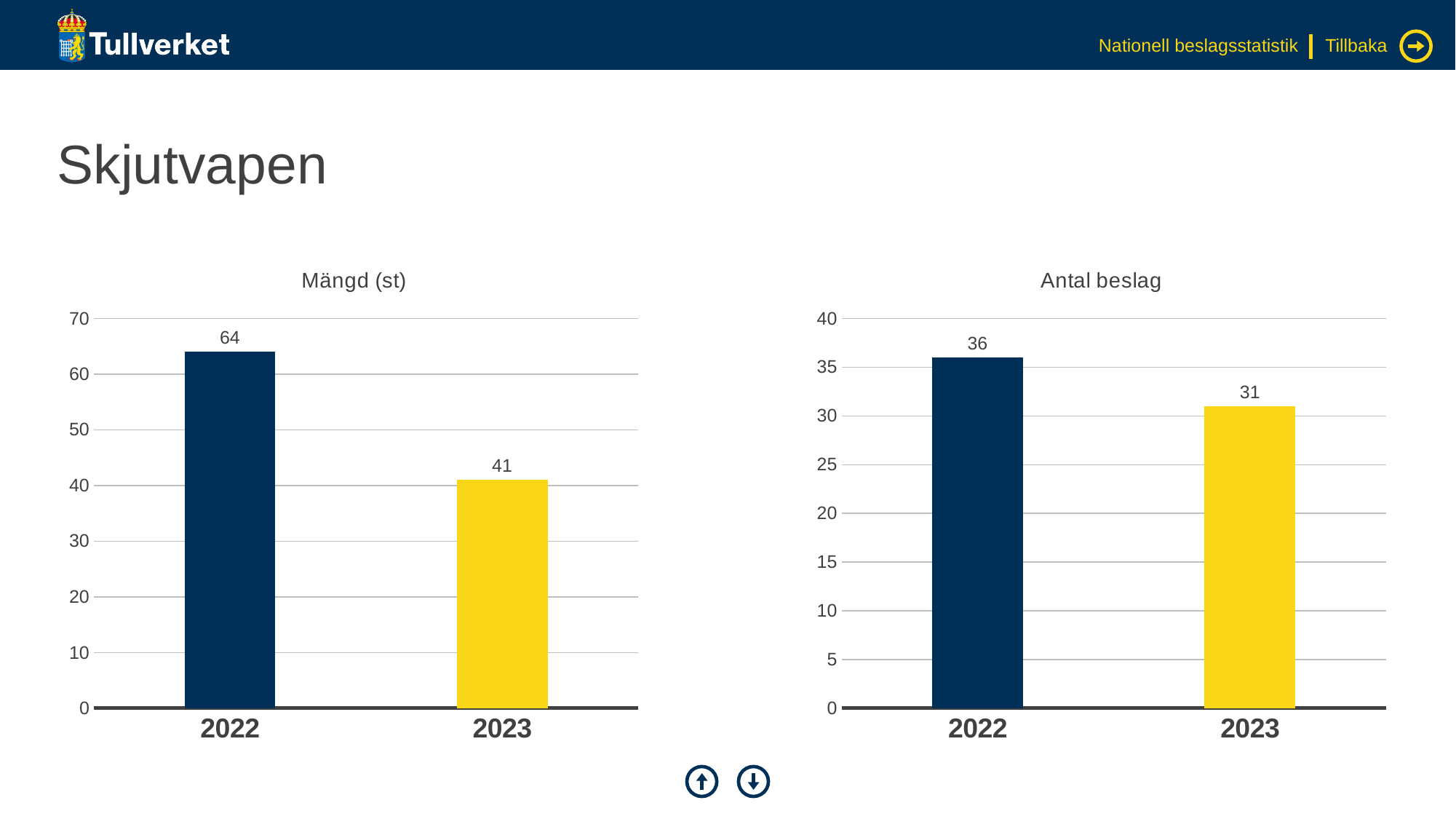
In the 'Mängd (st)' chart, which year has the highest value? 2022 In the 'Antal beslag' chart, what is the value for 2022? 36 In the 'Mängd (st)' chart, what is the difference between the 2022 and 2023 values? 23 What type of chart is the 'Antal beslag' chart? bar chart In the 'Mängd (st)' chart, do the values rise or fall from 2022 to 2023? fall In the 'Antal beslag' chart, what is the difference between the 2022 and 2023 values? 5 In the 'Mängd (st)' chart, what is the value for 2023? 41 In the 'Mängd (st)' chart, how many bars are shown? 2 In the 'Mängd (st)' chart, what is the value for 2022? 64 In the 'Antal beslag' chart, what is the value for 2023? 31 In the 'Antal beslag' chart, is the value for 2022 greater or less than 2023? greater In the 'Antal beslag' chart, which year has the lowest value? 2023